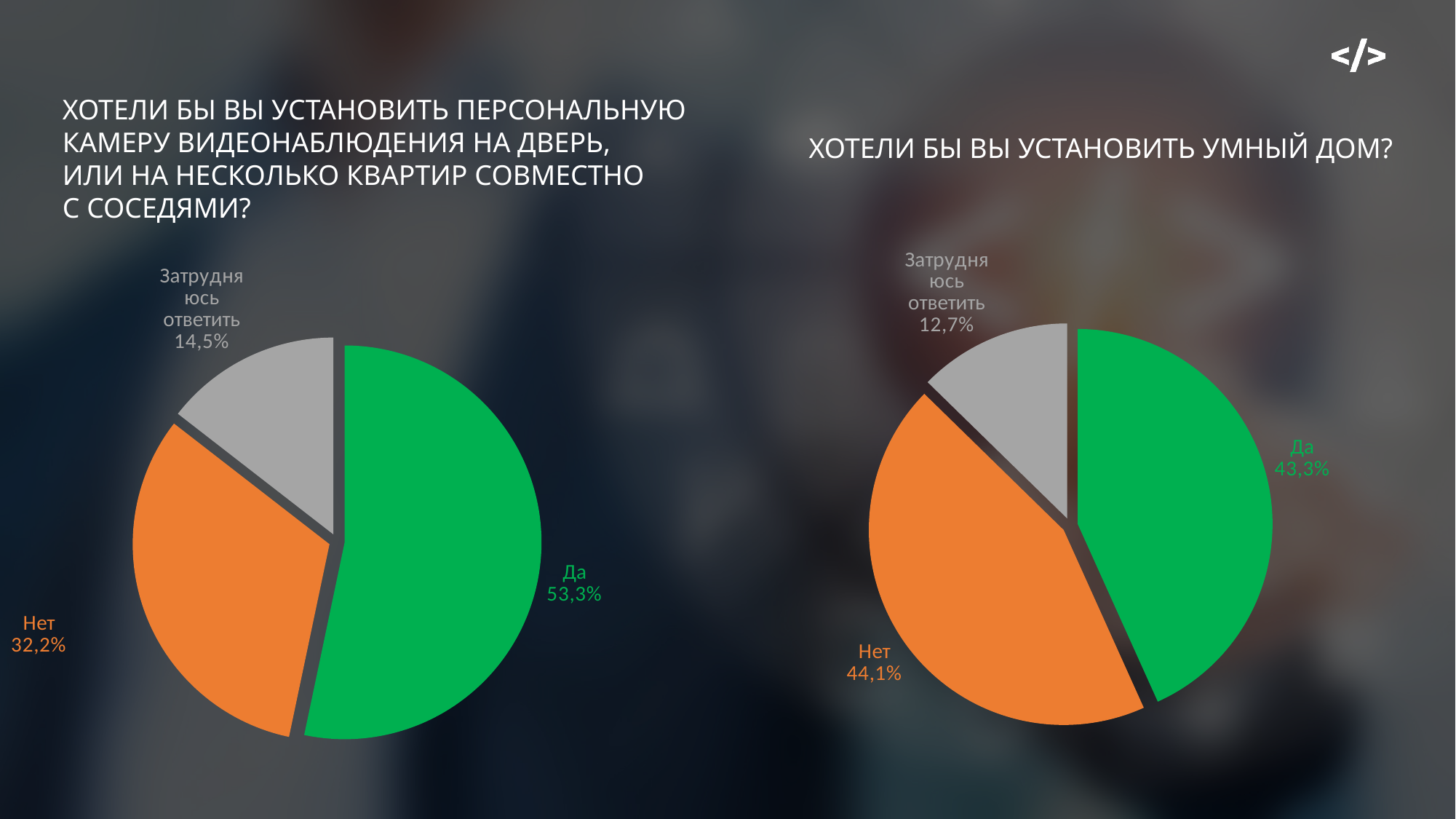
In the right pie chart ("Хотели бы вы установить умный дом?"), what share of respondents answered "Затрудняюсь ответить"? 12,7% What type of chart is used on the left side of the slide (about installing a video surveillance camera)? Pie chart In the right pie chart ("Хотели бы вы установить умный дом?"), what share of respondents answered "Да"? 43,3% In the left pie chart (about installing a video surveillance camera), what is the difference in percentage points between the "Да" and "Нет" shares? 21,1 How many slices does the right pie chart ("Хотели бы вы установить умный дом?") have? 3 In the right pie chart ("Хотели бы вы установить умный дом?"), which answer has the smallest share? Затрудняюсь ответить In the right pie chart ("Хотели бы вы установить умный дом?"), which share is larger, "Да" or "Нет"? Нет In the left pie chart (about installing a video surveillance camera), what share of respondents answered "Нет"? 32,2% In the right pie chart ("Хотели бы вы установить умный дом?"), what share of respondents answered "Нет"? 44,1% In the left pie chart (about installing a video surveillance camera), what share of respondents answered "Да"? 53,3% In the left pie chart (about installing a video surveillance camera), which answer has the largest share? Да In the left pie chart (about installing a video surveillance camera), what share of respondents answered "Затрудняюсь ответить"? 14,5%